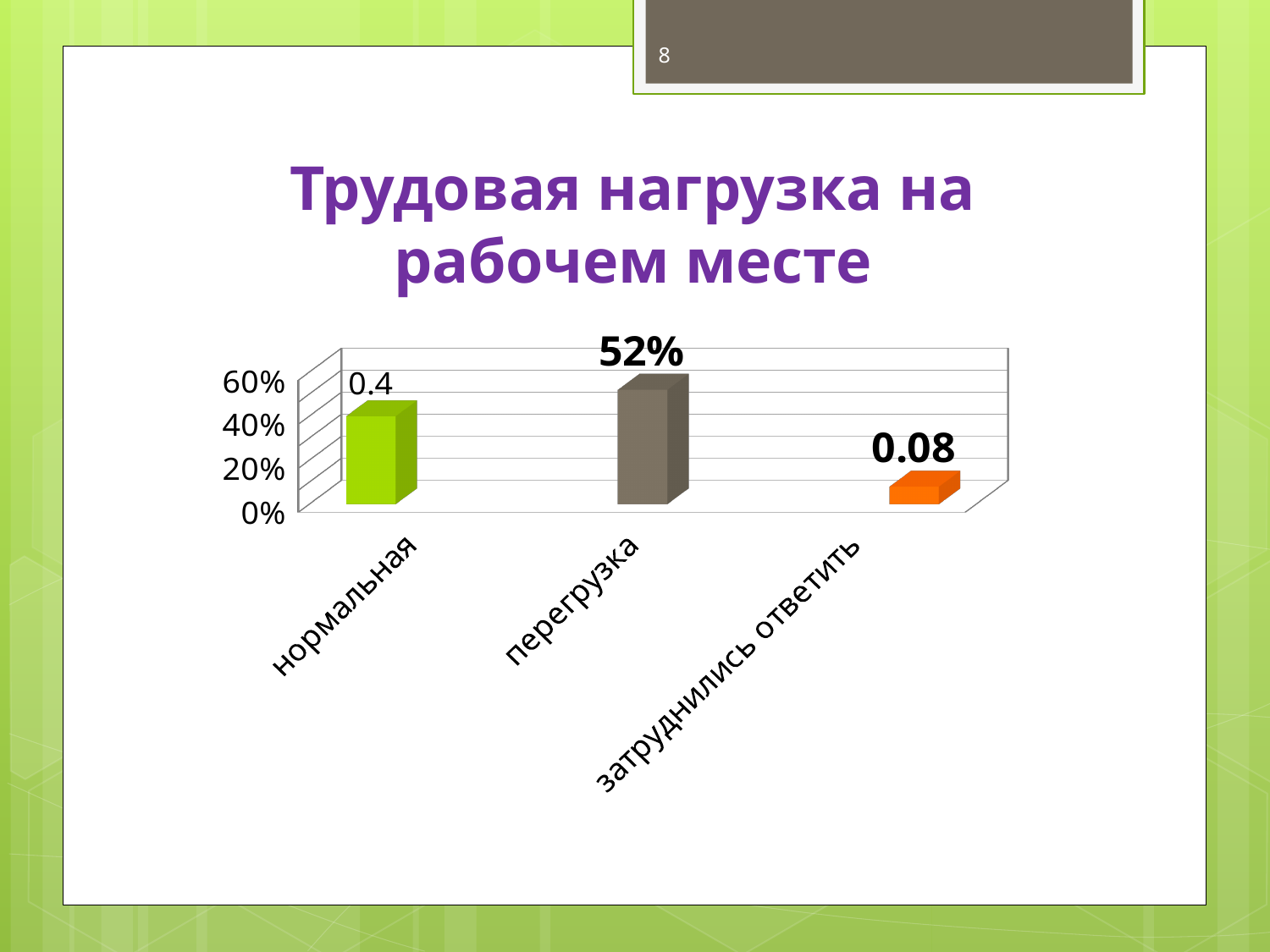
Which category has the lowest value? затруднились ответить Which category has the highest value? перегрузка Is the value for "затруднились ответить" greater or less than 20%? less What is the difference between the values for "нормальная" and "затруднились ответить"? 0.32 What kind of chart is shown on the slide? bar chart What value is shown for the category "затруднились ответить"? 0.08 How many categories are shown on the chart? 3 What value is shown for the category "нормальная"? 0.4 What is the title of the slide containing the chart? Трудовая нагрузка на рабочем месте What value is shown for the category "перегрузка"? 52% Is the value for "перегрузка" greater or less than 40%? greater Which is larger, the value for "нормальная" or the value for "затруднились ответить"? нормальная